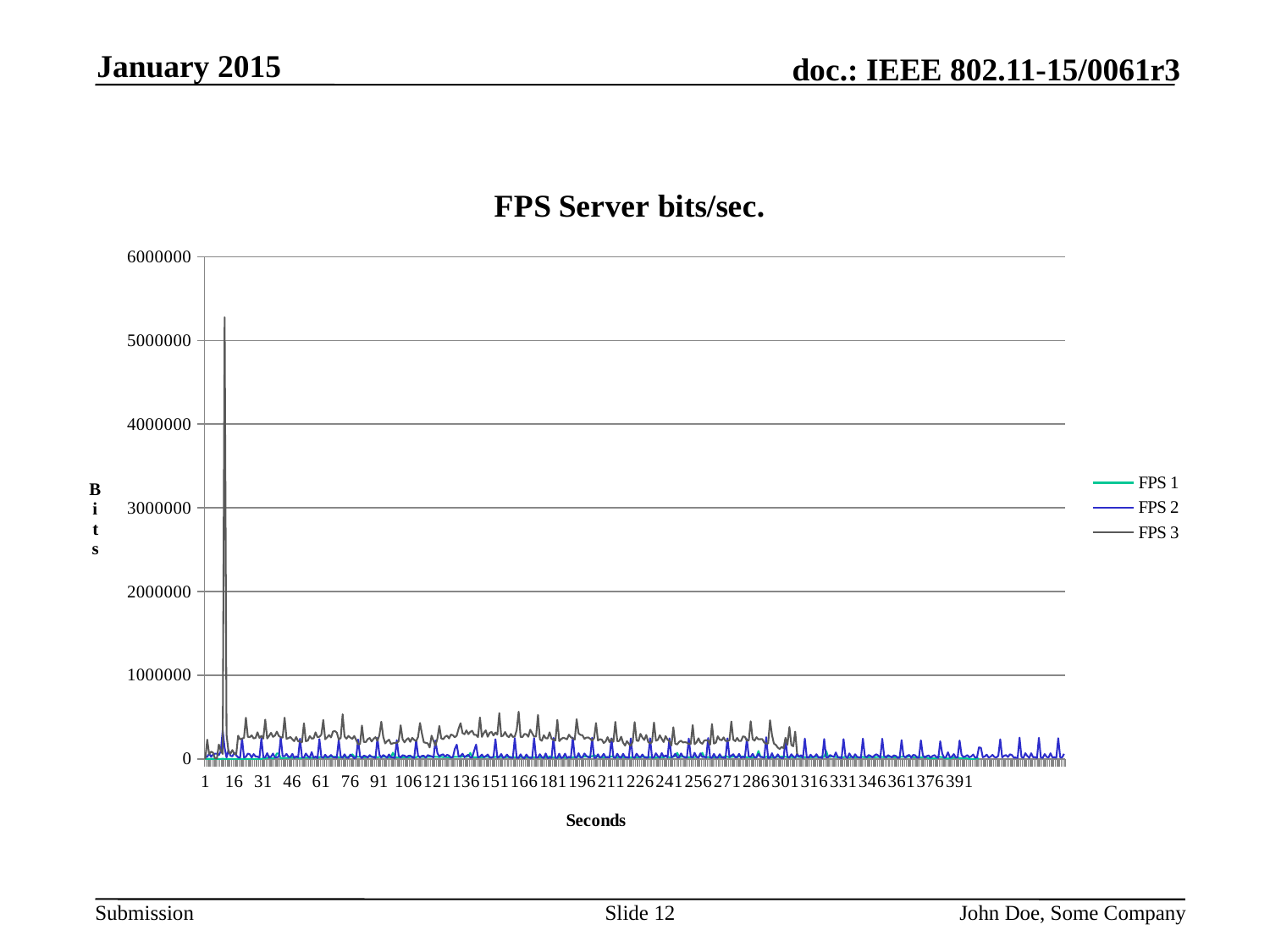
Is the highest peak of the FPS 1 series greater or less than 1000000? less What is the title of the chart? FPS Server bits/sec. Is the highest peak of the FPS 3 series greater or less than 5000000? greater What are the names of the series listed in the legend? FPS 1, FPS 2, FPS 3 What is the highest value shown on the y axis? 6000000 Is the highest peak of the FPS 3 series greater or less than 6000000? less Which series has the higher peak, FPS 2 or FPS 3? FPS 3 Which series reaches the highest peak value on the chart? FPS 3 What kind of chart is shown on the slide? line chart How many series does the legend list? 3